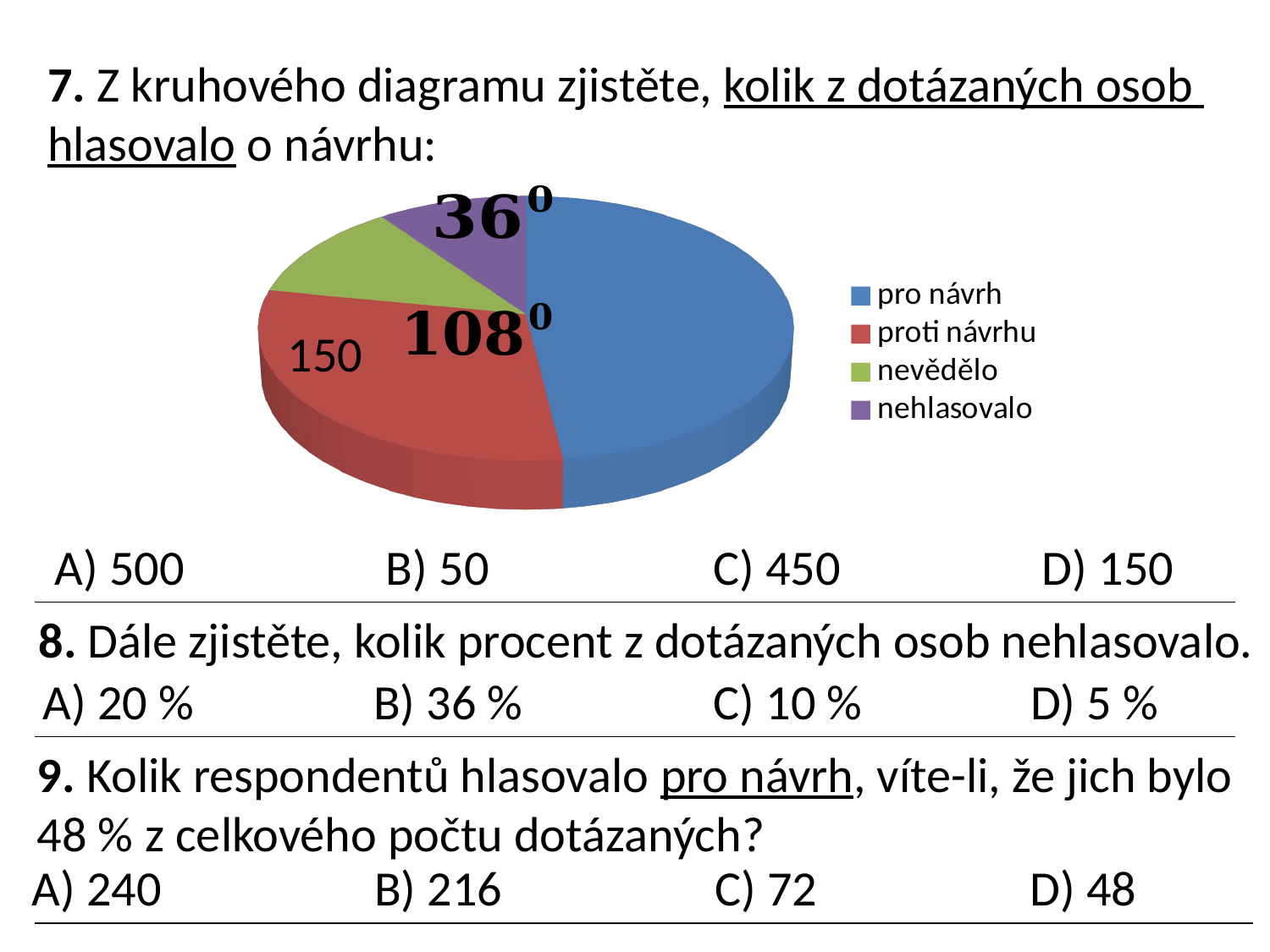
How many slices does the pie chart have? 4 Which category has the smallest slice of the pie chart? nehlasovalo Which category has the largest slice of the pie chart? pro návrh What kind of chart is shown on the slide? pie chart What value is printed on the proti návrhu slice of the pie chart? 150 What angle is printed next to the nehlasovalo slice of the pie chart? 36° Which slice is larger, nevědělo or nehlasovalo? nevědělo How many entries does the legend of the pie chart list? 4 Which slice is larger, proti návrhu or nevědělo? proti návrhu What colour is the pro návrh slice in the pie chart? blue Which slice is larger, pro návrh or proti návrhu? pro návrh Which category does the green slice of the pie chart represent? nevědělo